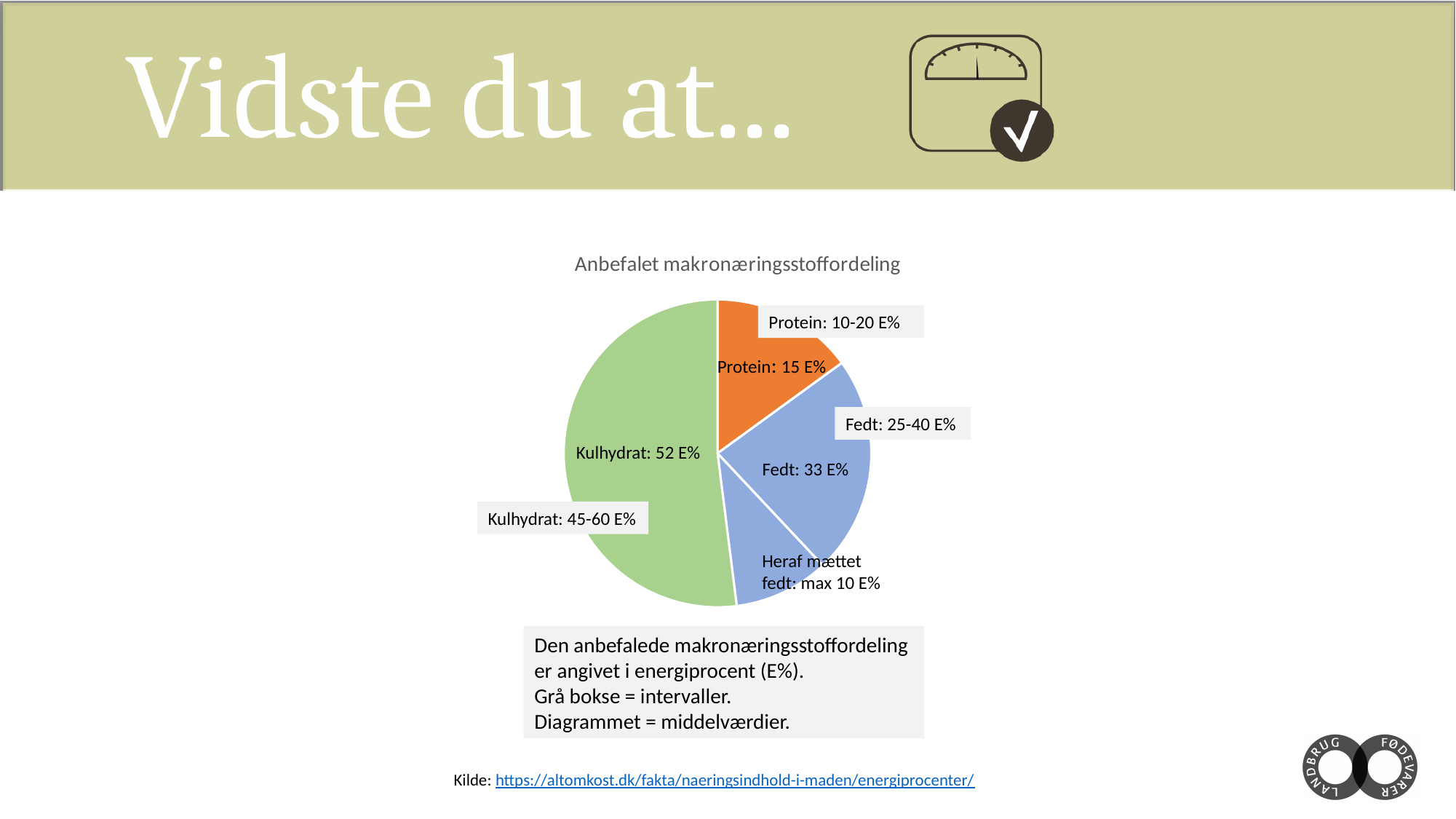
What value is shown for Protein in the pie chart? 15 E% What kind of chart is shown on the slide? Pie chart What interval is given in the grey box for Kulhydrat? 45-60 E% What value is shown for Kulhydrat in the pie chart? 52 E% Which is larger, the Fedt slice or the Protein slice? Fedt What value is shown for Fedt in the pie chart? 33 E% What interval is given in the grey box for Fedt? 25-40 E% Which macronutrient has the smallest slice of the pie? Heraf mættet fedt What is the difference between the Fedt value and the Protein value? 18 E% Which macronutrient has the largest slice of the pie? Kulhydrat What is the difference between the Kulhydrat value and the Fedt value? 19 E% What is the title of the chart? Anbefalet makronæringsstoffordeling